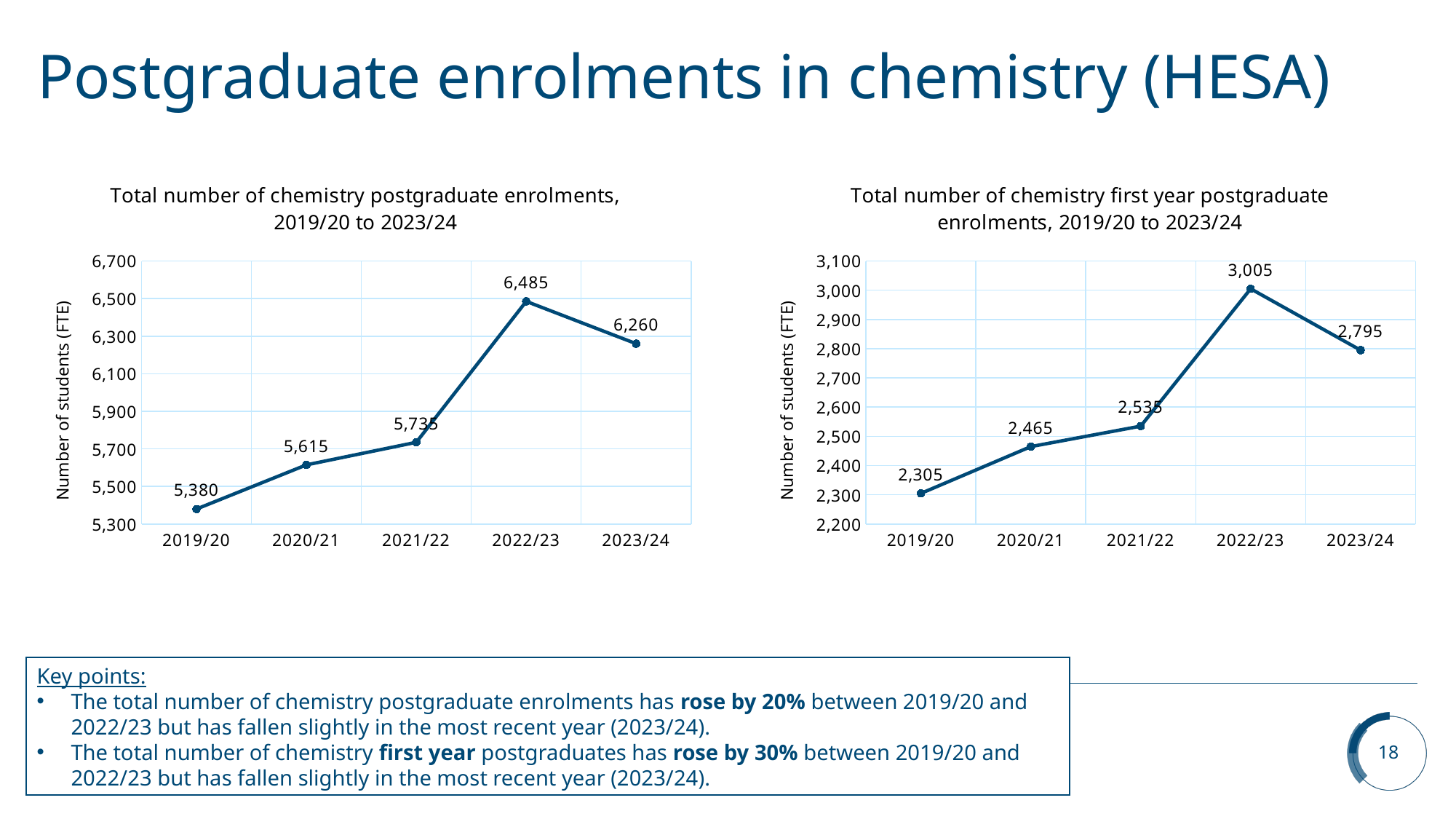
In the left chart (Total number of chemistry postgraduate enrolments), what is the value for 2022/23? 6,485 In the right chart (Total number of chemistry first year postgraduate enrolments), which is larger: the value for 2021/22 or the value for 2023/24? 2023/24 In the left chart (Total number of chemistry postgraduate enrolments), what is the value for 2019/20? 5,380 In the left chart (Total number of chemistry postgraduate enrolments), do the values rise or fall from 2019/20 to 2022/23? Rise In the left chart (Total number of chemistry postgraduate enrolments), what is the difference between the 2022/23 and 2023/24 values? 225 In the right chart (Total number of chemistry first year postgraduate enrolments), what is the difference between the 2022/23 and 2019/20 values? 700 How many data points are plotted in the left chart (Total number of chemistry postgraduate enrolments)? 5 In the left chart (Total number of chemistry postgraduate enrolments), which year has the highest value? 2022/23 In the right chart (Total number of chemistry first year postgraduate enrolments), what is the value for 2020/21? 2,465 In the right chart (Total number of chemistry first year postgraduate enrolments), what is the value for 2023/24? 2,795 What kind of chart is the right chart (Total number of chemistry first year postgraduate enrolments)? Line chart In the right chart (Total number of chemistry first year postgraduate enrolments), which year has the lowest value? 2019/20